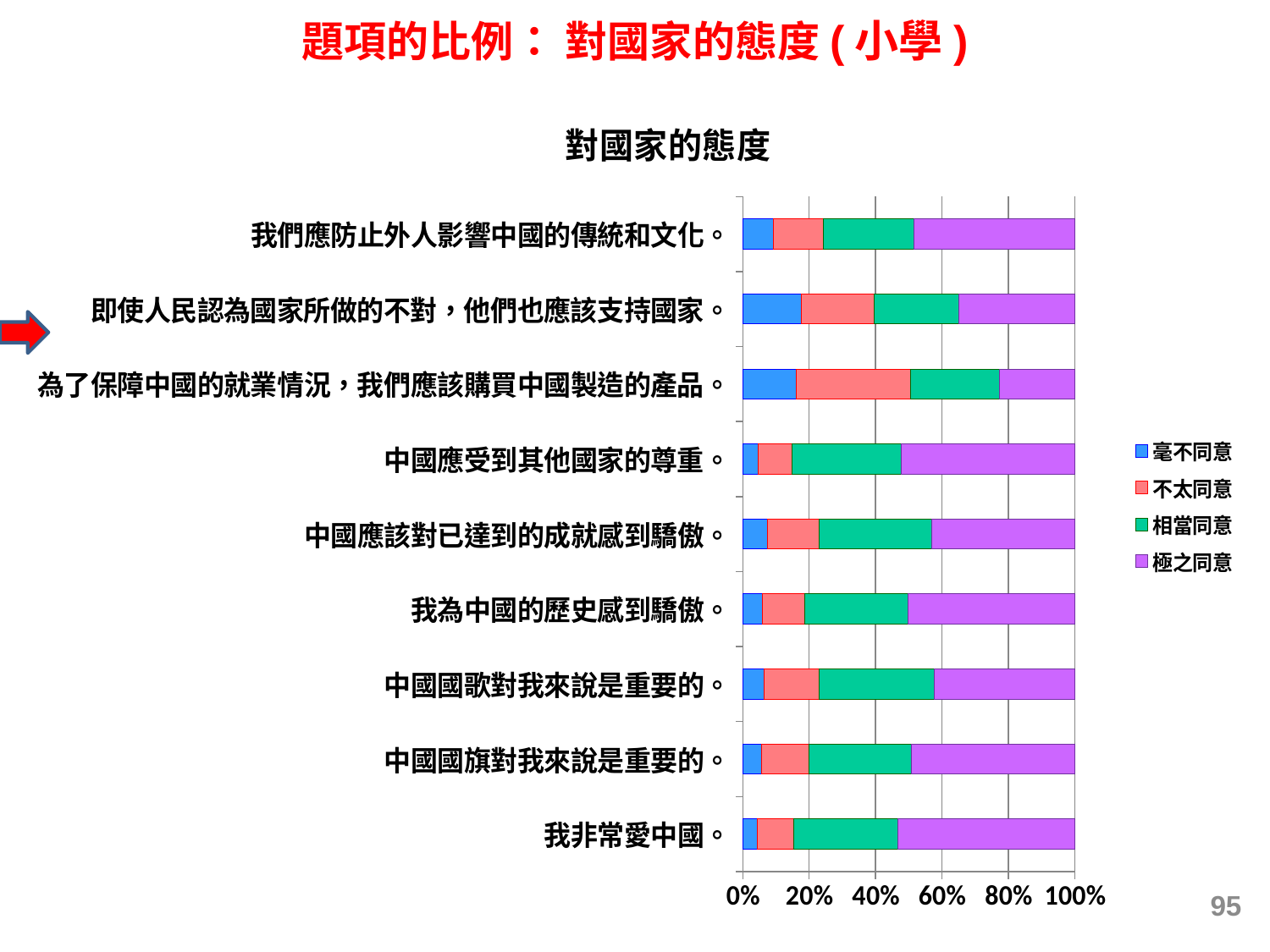
How many statements (categories) are plotted in the chart? 9 Is the 毫不同意 share for 我非常愛中國。 greater or less than 20%? less Which legend entry is shown in purple? 極之同意 Which has the larger 極之同意 share: 我非常愛中國。 or 即使人民認為國家所做的不對，他們也應該支持國家。? 我非常愛中國。 Is the 極之同意 share for 我非常愛中國。 greater or less than 40%? greater How many series does the legend list? 4 What kind of chart is shown on the slide? Stacked bar chart Which has the larger 毫不同意 share: 我們應防止外人影響中國的傳統和文化。 or 我非常愛中國。? 我們應防止外人影響中國的傳統和文化。 Which statement has the largest 不太同意 share? 為了保障中國的就業情況，我們應該購買中國製造的產品。 What is the title of the chart? 對國家的態度 Which statement has the smallest 極之同意 share? 為了保障中國的就業情況，我們應該購買中國製造的產品。 Is the combined share of 毫不同意 and 不太同意 for 為了保障中國的就業情況，我們應該購買中國製造的產品。 greater or less than 40%? greater